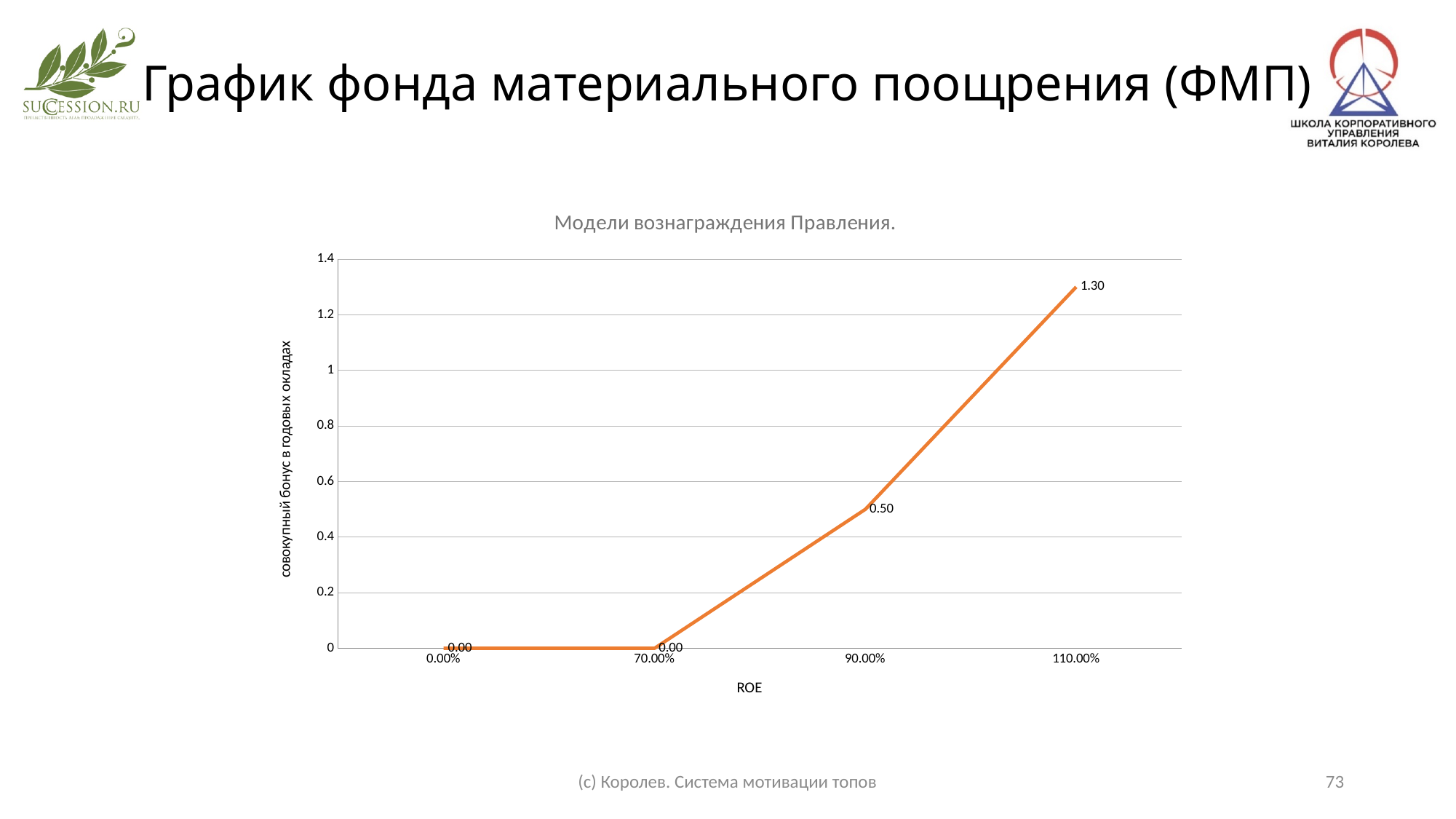
What kind of chart is shown on the slide? line chart Which is larger, the value at ROE 90.00% or at ROE 110.00%? 110.00% Is the value at ROE 110.00% greater or less than 1.2? greater What is the value at ROE 90.00%? 0.50 Do the values rise or fall as ROE increases from 70.00% to 110.00%? rise What is the title of the chart? Модели вознаграждения Правления. What is the difference between the values at ROE 110.00% and ROE 90.00%? 0.80 What is the value at ROE 70.00%? 0.00 At which ROE level is the value highest? 110.00% How many ROE points are plotted on the chart? 4 What is the value at ROE 110.00%? 1.30 What is the value at ROE 0.00%? 0.00